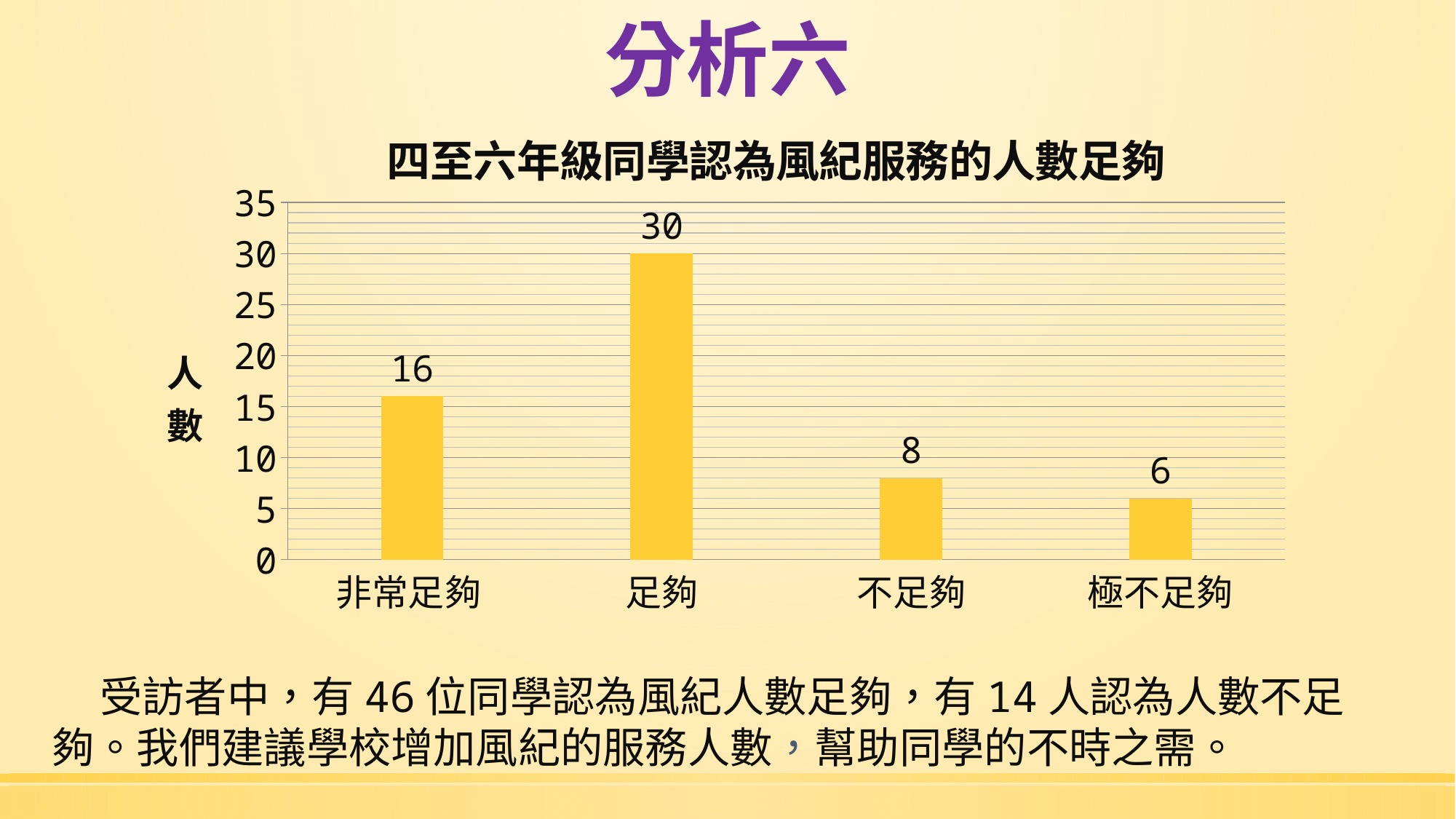
What is the title of the chart? 四至六年級同學認為風紀服務的人數足夠 Which category has the lowest value? 極不足夠 What kind of chart is shown on the slide? bar chart Is the value for 足夠 greater or less than 25? greater Which is larger, the value for 不足夠 or the value for 極不足夠? 不足夠 What is the value for 極不足夠? 6 How many categories are shown on the x axis? 4 What is the value for 足夠? 30 What is the value for 非常足夠? 16 What is the value for 不足夠? 8 What is the difference between the values for 足夠 and 非常足夠? 14 Which category has the highest value? 足夠